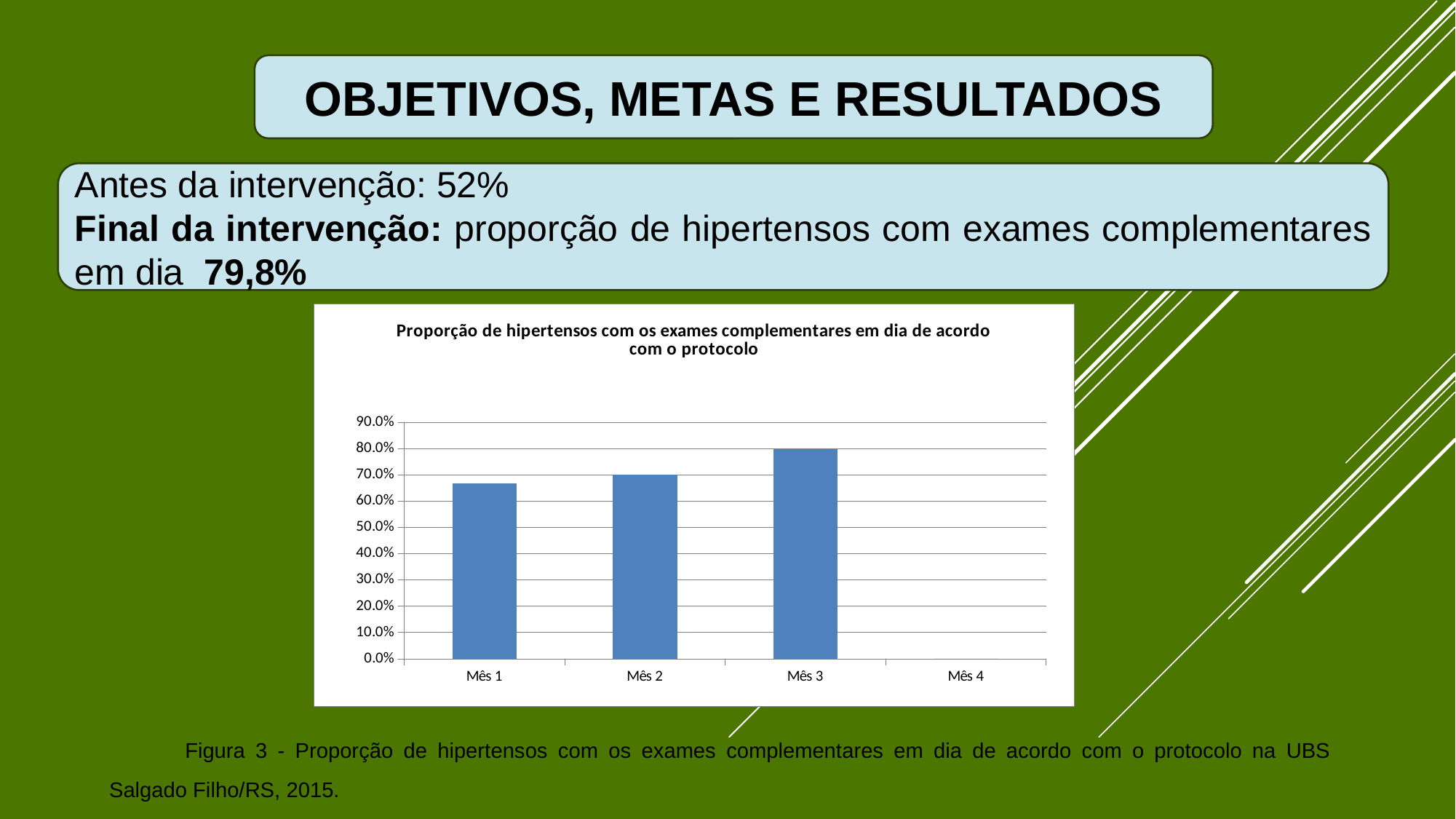
Which month category on the x axis has no bar plotted? Mês 4 How many month categories are shown on the x axis of the chart? 4 Do the bar values rise or fall from Mês 1 to Mês 3? rise What kind of chart is shown on the slide? bar chart Is the value for Mês 1 greater or less than 70.0%? less Which is larger, the value for Mês 1 or the value for Mês 3? Mês 3 Is the value for Mês 3 greater or less than 70.0%? greater Which month has the highest bar in the chart? Mês 3 Is the value for Mês 1 greater or less than 60.0%? greater What is the title of the chart? Proporção de hipertensos com os exames complementares em dia de acordo com o protocolo Among Mês 1, Mês 2 and Mês 3, which month has the lowest bar? Mês 1